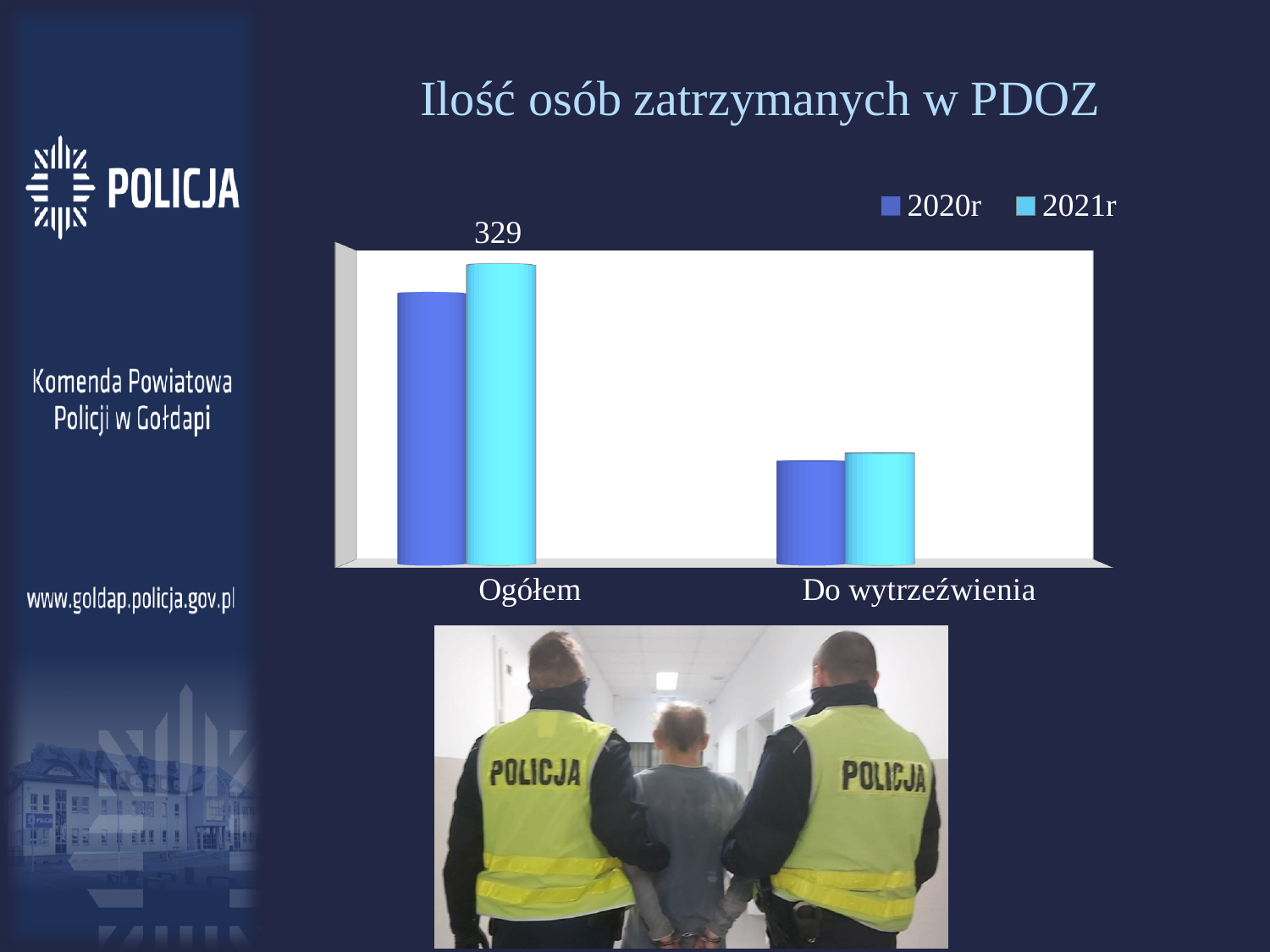
In the Ogółem category, which year has the larger value, 2020r or 2021r? 2021r What is the title of the chart? Ilość osób zatrzymanych w PDOZ Which series are listed in the legend? 2020r and 2021r Which category has the highest values? Ogółem What is the value for 2021r in the Ogółem category? 329 Is the 2020r value for Ogółem larger or smaller than the 2020r value for Do wytrzeźwienia? larger How many categories are shown on the x axis? 2 How many series does the legend list? 2 Which category has the lowest values? Do wytrzeźwienia Which category is labelled on the right side of the x axis? Do wytrzeźwienia What type of chart is shown on the slide? bar chart